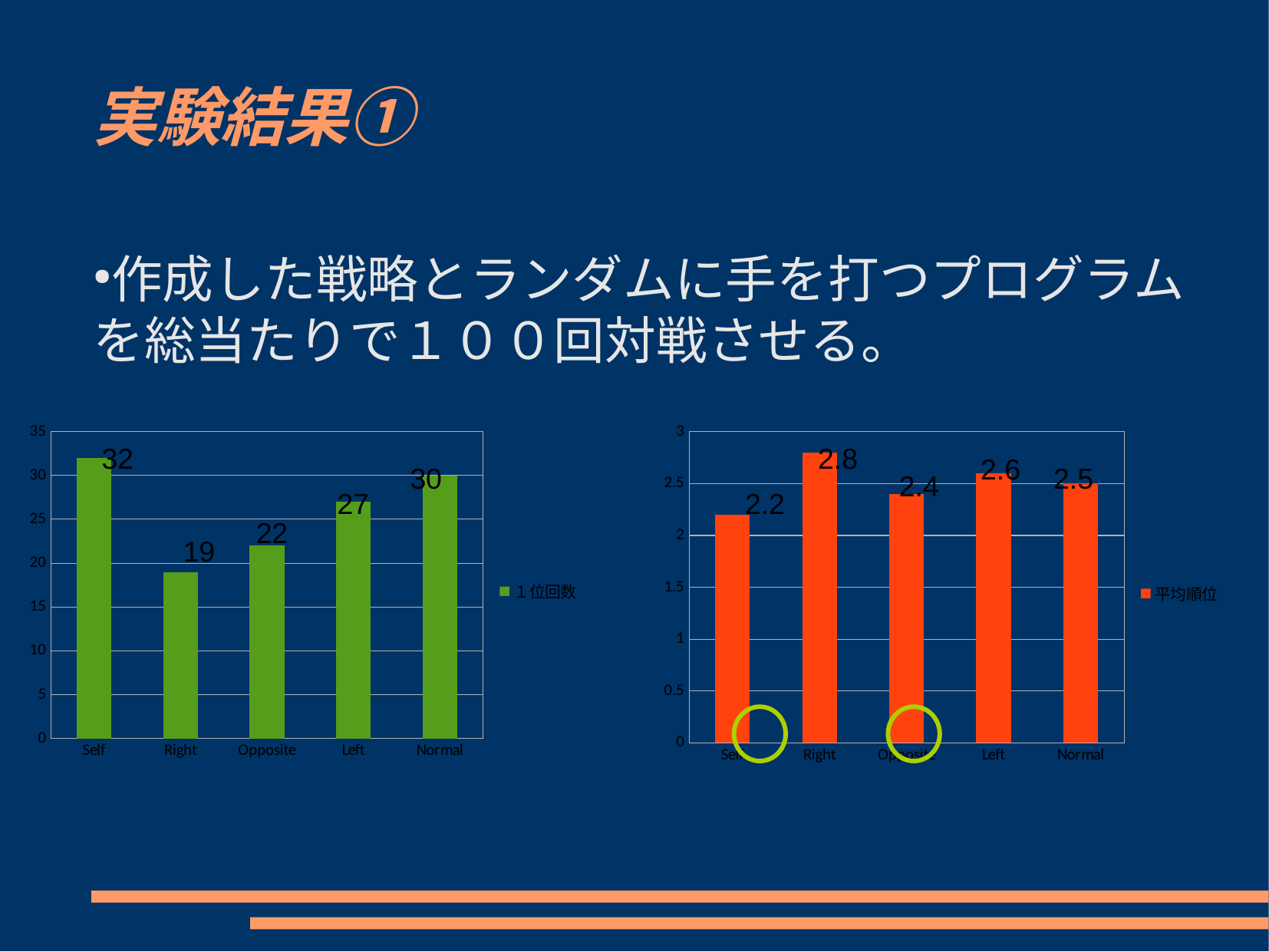
In the left chart (１位回数), how many categories are shown on the x axis? 5 In the left chart (１位回数), what is the value for Self? 32 How many series does the legend of the left chart list? 1 In the right chart (平均順位), which category has the lowest value? Self In the left chart (１位回数), which category has the highest value? Self What kind of chart is the right chart (平均順位)? Bar chart In the left chart (１位回数), which category has the lowest value? Right In the right chart (平均順位), what is the value for Right? 2.8 In the left chart (１位回数), what is the difference between the values for Self and Opposite? 10 In the left chart (１位回数), what is the value for Right? 19 In the right chart (平均順位), what is the value for Normal? 2.5 In the right chart (平均順位), which is larger, the value for Left or the value for Opposite? Left